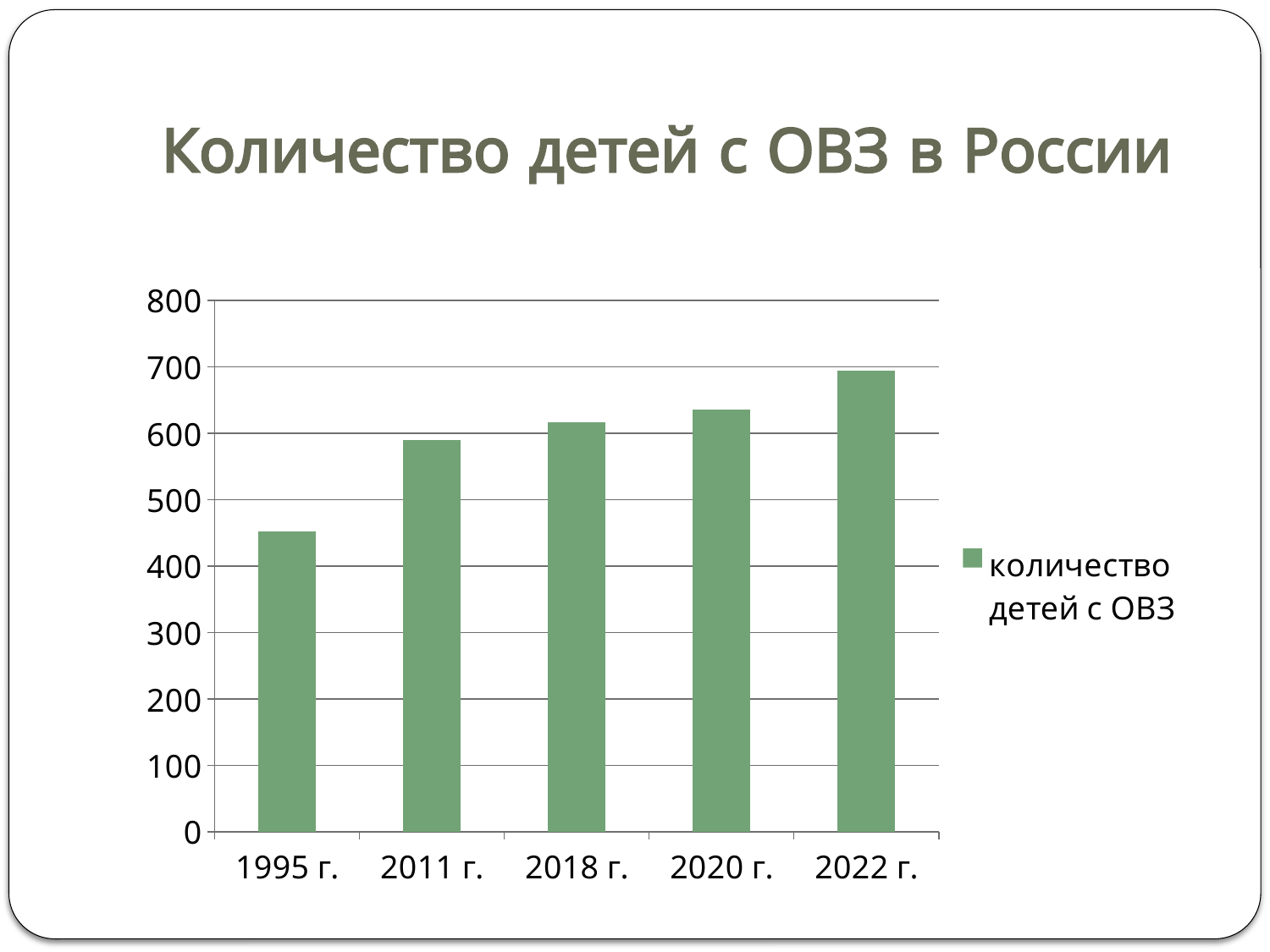
Is the value for 1995 г. greater or less than 500? less Which is larger, the value for 1995 г. or the value for 2011 г.? 2011 г. Is the value for 2022 г. greater or less than 600? greater Which year has the lowest value? 1995 г. How many series does the legend list? 1 Which year has the highest value? 2022 г. Is the value for 2018 г. greater or less than 600? greater What is the title of the chart? Количество детей с ОВЗ в России How many years (categories) are shown on the x axis? 5 Do the values rise or fall from 1995 г. to 2022 г.? rise What type of chart is shown on the slide? bar chart